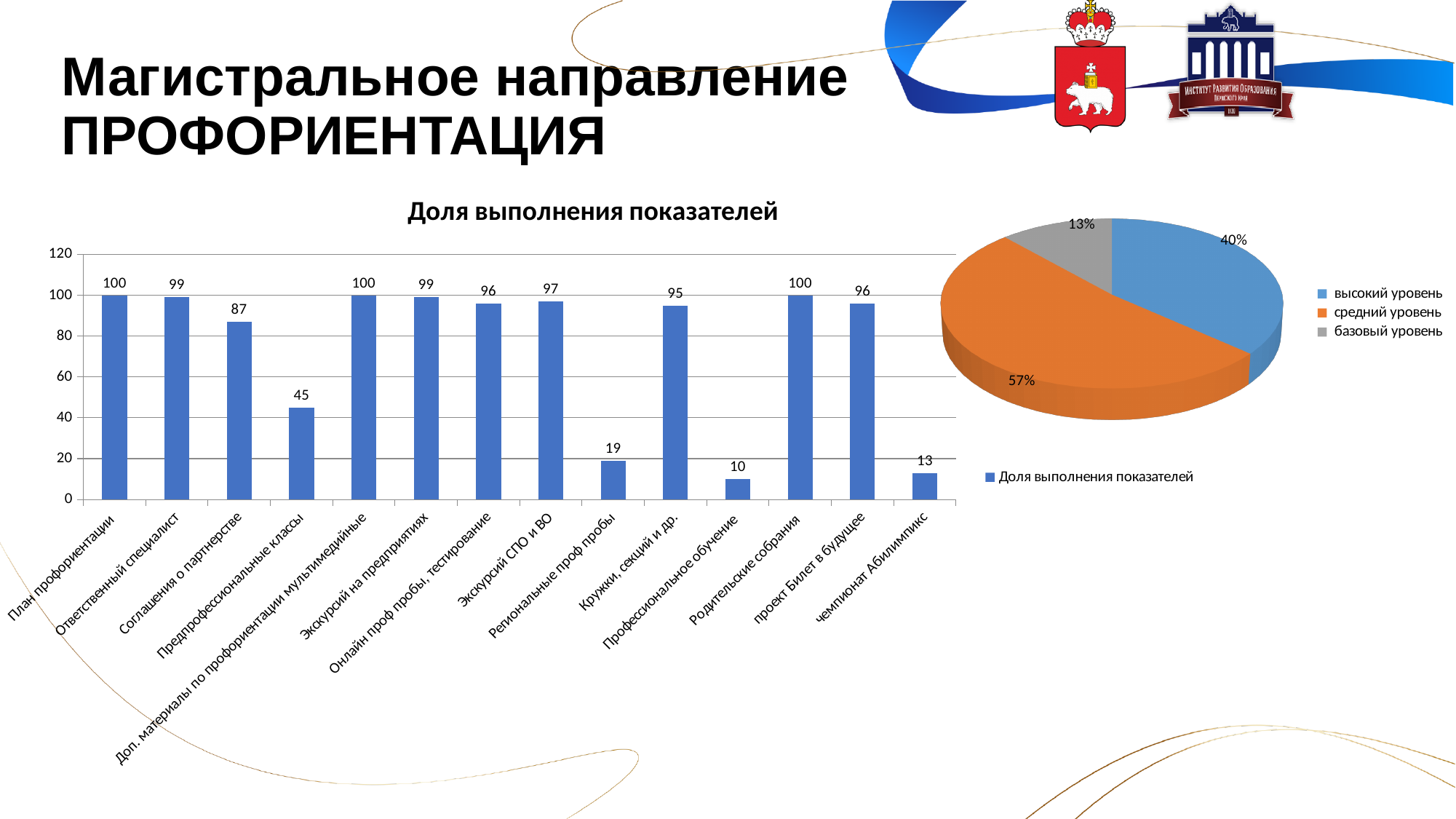
In the bar chart 'Доля выполнения показателей', what is the value for 'Предпрофессиональные классы'? 45 In the bar chart 'Доля выполнения показателей', what is the value for 'Региональные проф пробы'? 19 In the bar chart 'Доля выполнения показателей', which category has the lowest value? Профессиональное обучение How many entries does the legend of the pie chart on the right list? 3 In the bar chart 'Доля выполнения показателей', what is the difference between the values for 'Экскурсий СПО и ВО' and 'чемпионат Абилимпикс'? 84 How many categories are shown in the bar chart 'Доля выполнения показателей'? 14 In the bar chart 'Доля выполнения показателей', which is larger: the value for 'Кружки, секций и др.' or the value for 'Соглашения о партнерстве'? Кружки, секций и др. In the bar chart 'Доля выполнения показателей', is the value for 'Предпрофессиональные классы' greater or less than 60? less In the pie chart on the right, which slice is the smallest? базовый уровень In the pie chart on the right, what share is shown for 'средний уровень'? 57% In the bar chart 'Доля выполнения показателей', what is the value for 'Соглашения о партнерстве'? 87 What kind of chart is the chart on the left titled 'Доля выполнения показателей'? bar chart